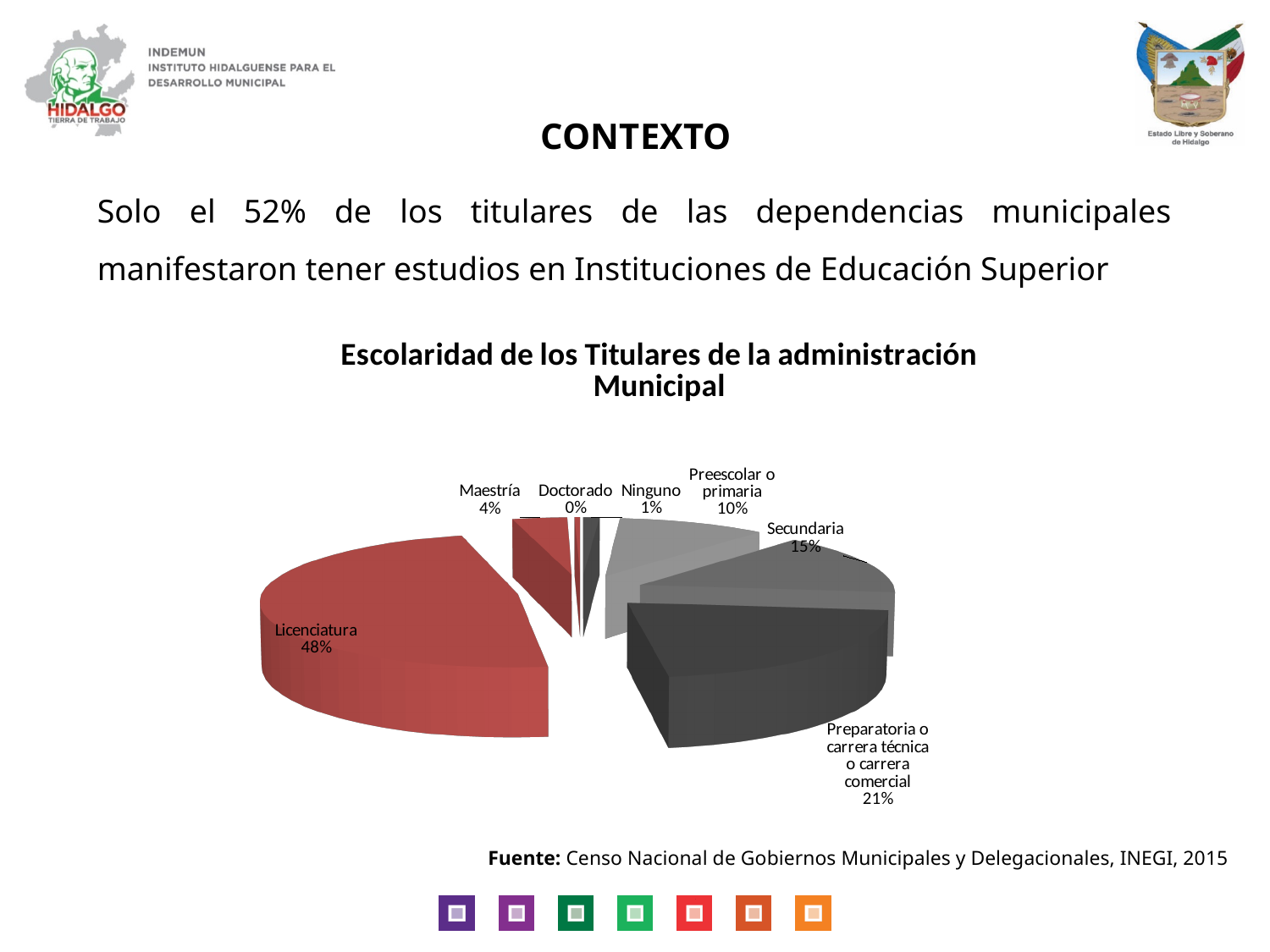
Which category has the largest share of the pie? Licenciatura Which is larger, the share for Secundaria or the share for Preescolar o primaria? Secundaria What percentage is shown for Secundaria? 15% What kind of chart is shown on the slide? Pie chart How many categories are shown in the pie chart? 7 Which category has the smallest share of the pie? Doctorado What percentage is shown for Maestría? 4% What percentage is shown for Doctorado? 0% What percentage is shown for Preparatoria o carrera técnica o carrera comercial? 21% What is the difference in percentage points between Licenciatura and Preparatoria o carrera técnica o carrera comercial? 27 What percentage of the pie corresponds to Licenciatura? 48% What is the title of the chart? Escolaridad de los Titulares de la administración Municipal